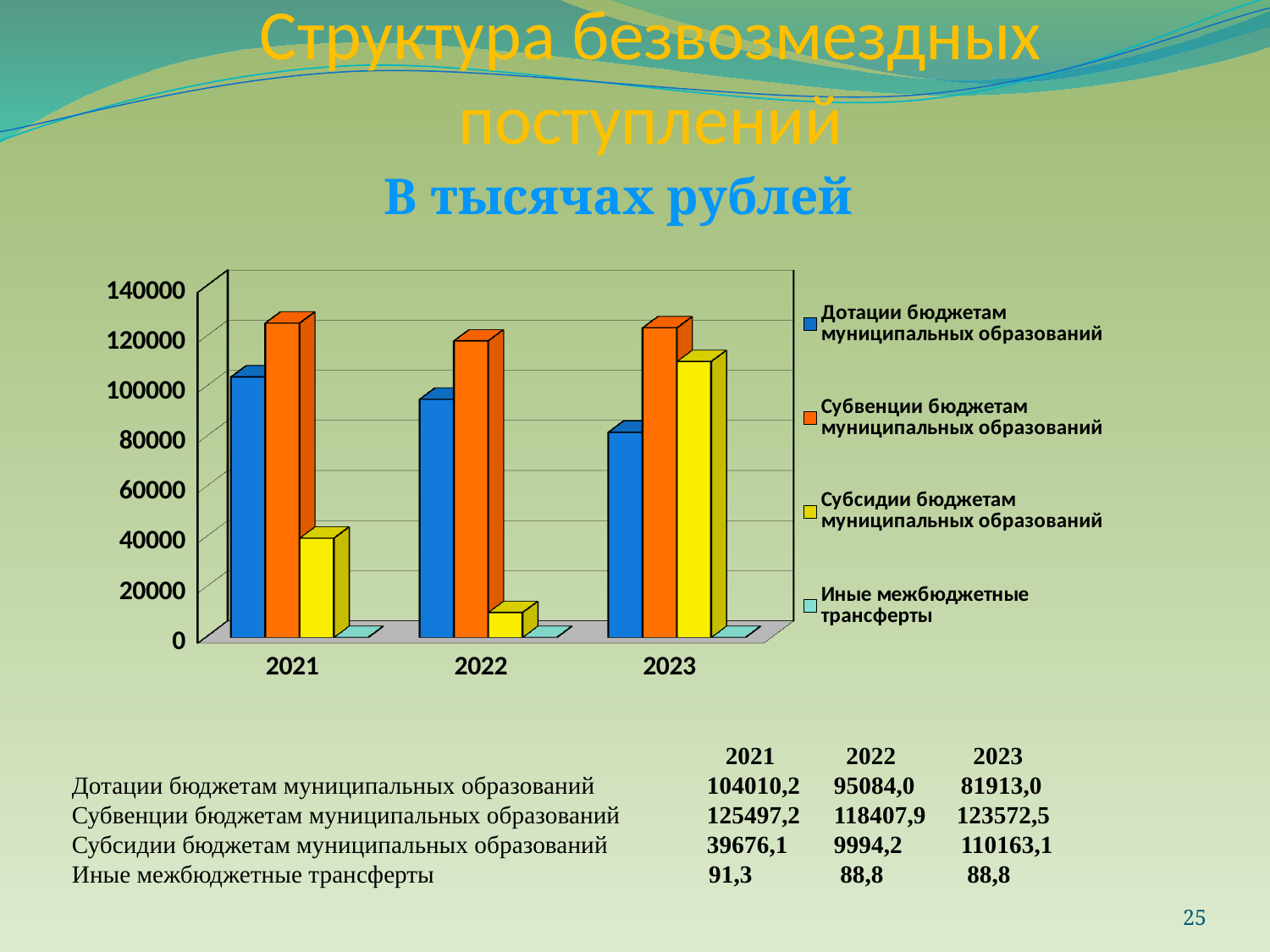
How many series does the chart legend list? 4 In 2023, which is larger: Субвенции бюджетам муниципальных образований or Субсидии бюджетам муниципальных образований? Субвенции бюджетам муниципальных образований What colour represents Субсидии бюджетам муниципальных образований in the chart? yellow What is the value of Дотации бюджетам муниципальных образований for 2021? 104010,2 How many years are shown along the x axis of the chart? 3 Is the value of Дотации бюджетам муниципальных образований for 2022 greater or less than 100000? less In which year is the value of Субсидии бюджетам муниципальных образований the lowest? 2022 What is the difference between the Субвенции бюджетам муниципальных образований values for 2021 and 2022? 7089,3 Do the values of Дотации бюджетам муниципальных образований rise or fall from 2021 to 2023? fall What is the value of Субсидии бюджетам муниципальных образований for 2023? 110163,1 In which year is the value of Субвенции бюджетам муниципальных образований the highest? 2021 What kind of chart is shown on the slide? bar chart